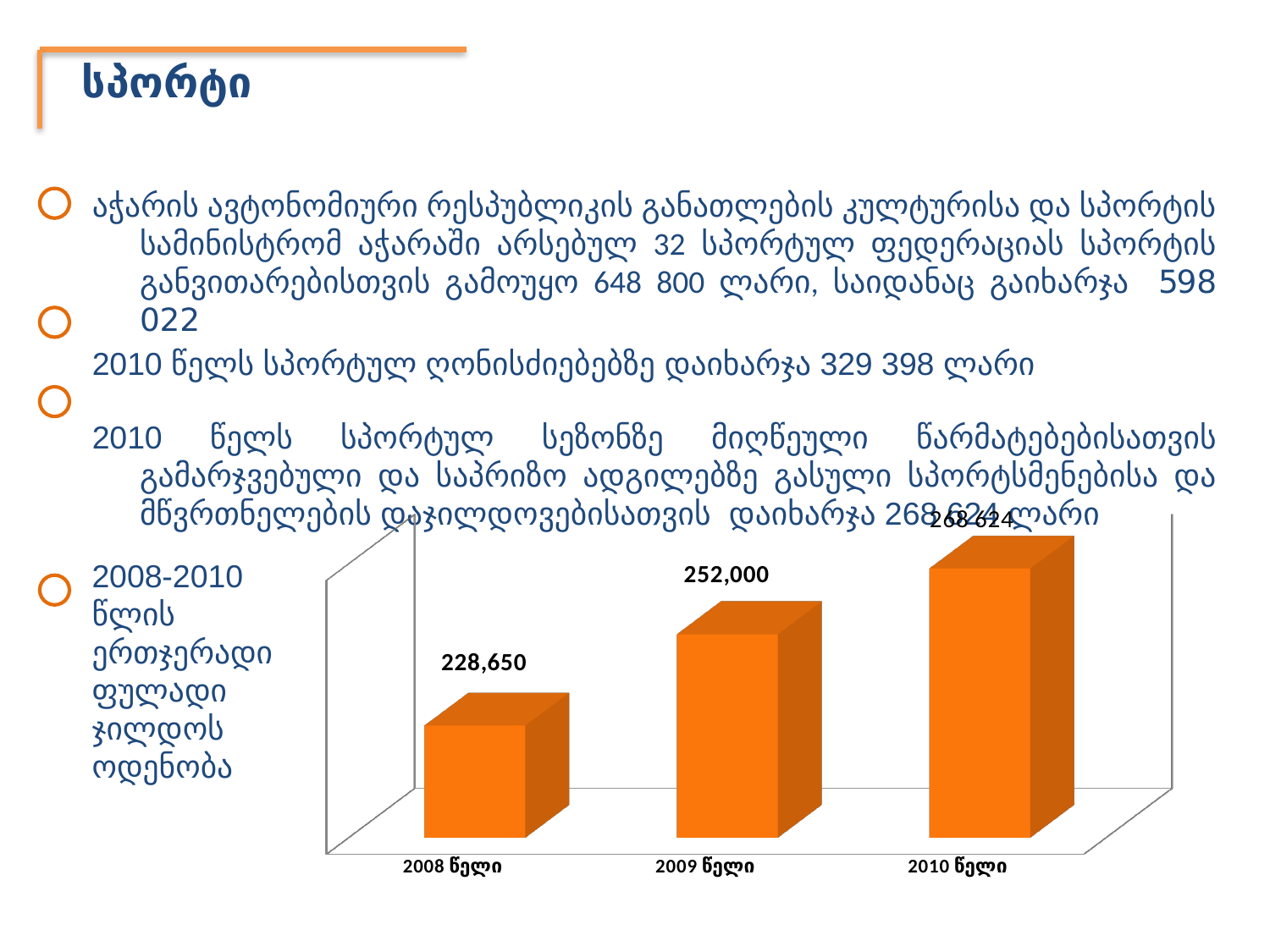
What is the value shown for 2008 წელი? 228,650 Which year has the lowest value in the chart? 2008 წელი What is the difference between the values for 2010 წელი and 2009 წელი? 16,624 Which year has the highest value in the chart? 2010 წელი Do the values rise or fall from 2008 წელი to 2010 წელი? rise Which is larger, the value for 2009 წელი or the value for 2008 წელი? 2009 წელი What is the difference between the values for 2009 წელი and 2008 წელი? 23,350 What kind of chart is shown on the slide? bar chart How many years (categories) are shown in the chart? 3 What is the difference between the values for 2010 წელი and 2008 წელი? 39,974 What is the value shown for 2009 წელი? 252,000 What is the value shown for 2010 წელი? 268,624